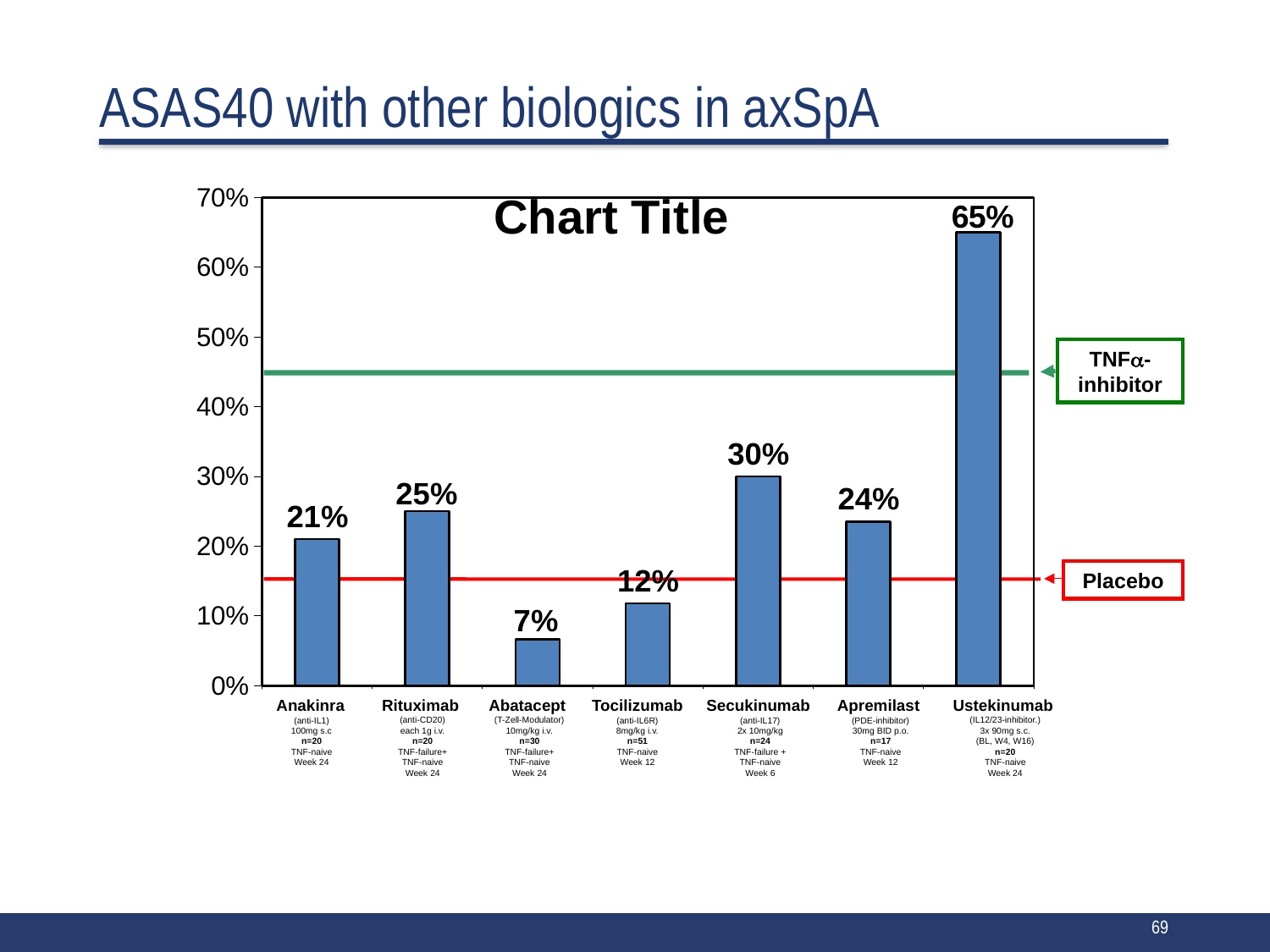
Which drug has the highest ASAS40 value? Ustekinumab What is the ASAS40 value for Abatacept? 7% Is the value for Secukinumab greater or less than 40%? less How many drugs are shown on the x axis of the chart? 7 What kind of chart is shown on the slide? bar chart Which has a higher ASAS40 value, Apremilast or Tocilizumab? Apremilast What is the ASAS40 value for Secukinumab? 30% What is the difference between the ASAS40 values for Rituximab and Anakinra? 4% What is the difference between the ASAS40 values for Ustekinumab and Secukinumab? 35% Which drug has the lowest ASAS40 value? Abatacept What is the ASAS40 value for Ustekinumab? 65% What does the red horizontal line on the chart represent? Placebo